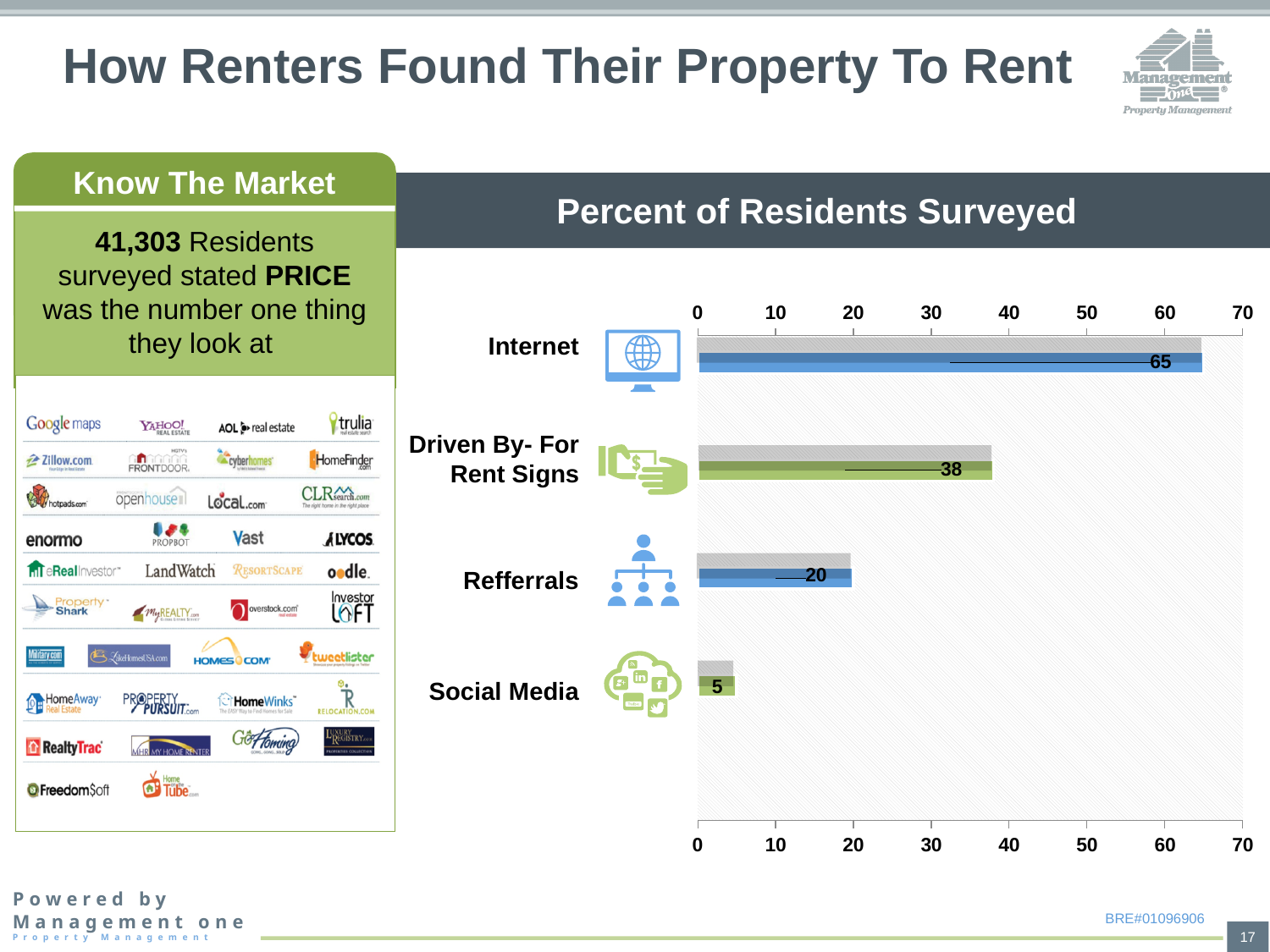
What is the title of the chart? Percent of Residents Surveyed What is the value for Refferrals? 20 What is the difference between the values for Internet and Driven By- For Rent Signs? 27 What is the difference between the values for Refferrals and Social Media? 15 What is the value for Internet? 65 What is the value for Driven By- For Rent Signs? 38 Which category has the lowest value? Social Media Which category has the highest value? Internet What kind of chart is shown on the slide? Bar chart Which is larger, the value for Driven By- For Rent Signs or the value for Refferrals? Driven By- For Rent Signs What is the value for Social Media? 5 How many categories are shown in the chart? 4